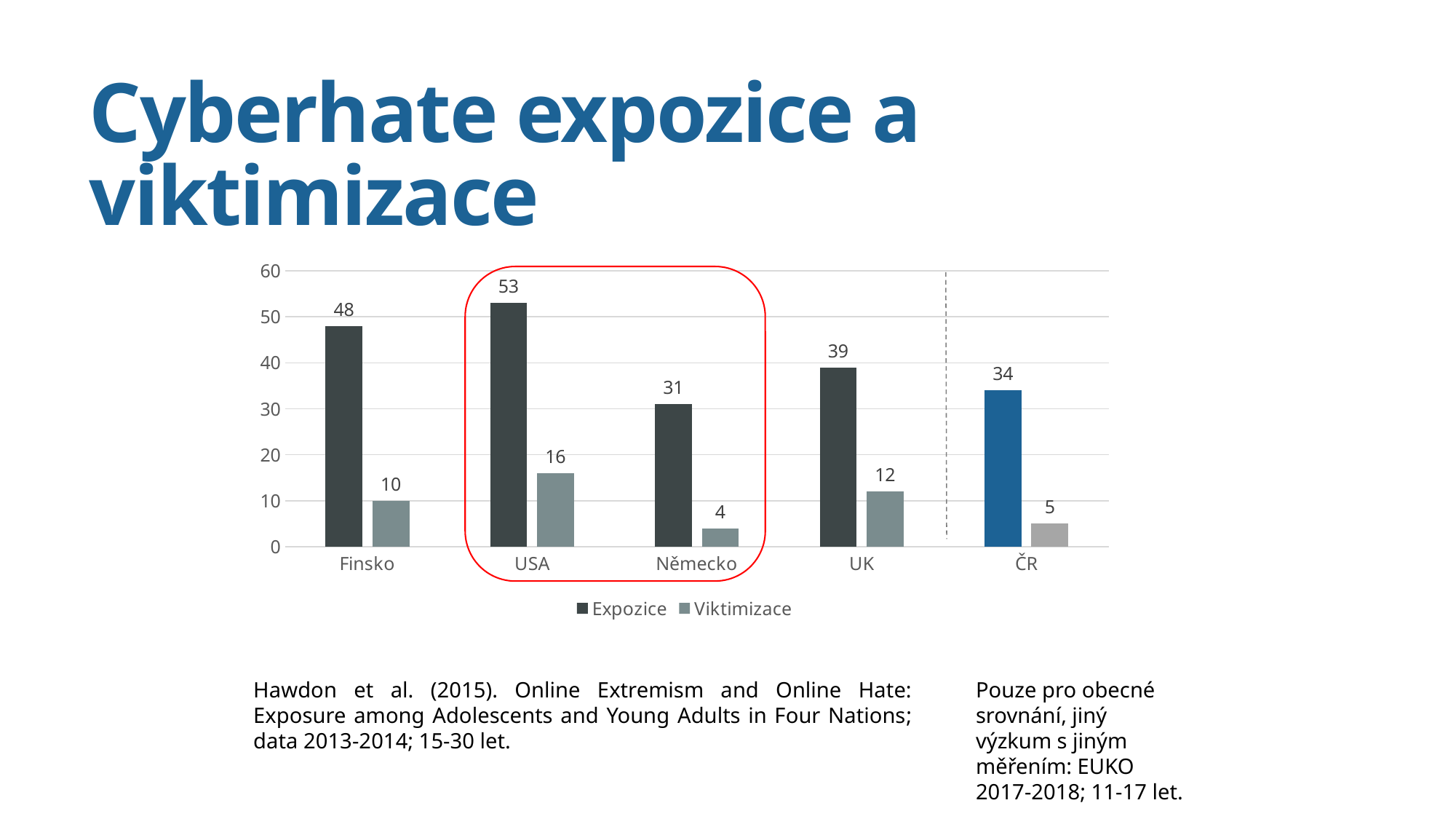
What is the difference between the Expozice values for USA and UK? 14 What is the Viktimizace value for Německo? 4 Which country has the lowest Viktimizace value? Německo Which is larger, the Viktimizace value for UK or for Finsko? UK What is the difference between the Expozice and Viktimizace values for Finsko? 38 How many countries are shown on the x axis? 5 What is the Expozice value for USA? 53 Which two countries are enclosed by the red rounded outline? USA and Německo Which country has the highest Expozice value? USA How many series does the legend list? 2 What kind of chart is shown on the slide? Bar chart What is the Expozice value for ČR? 34